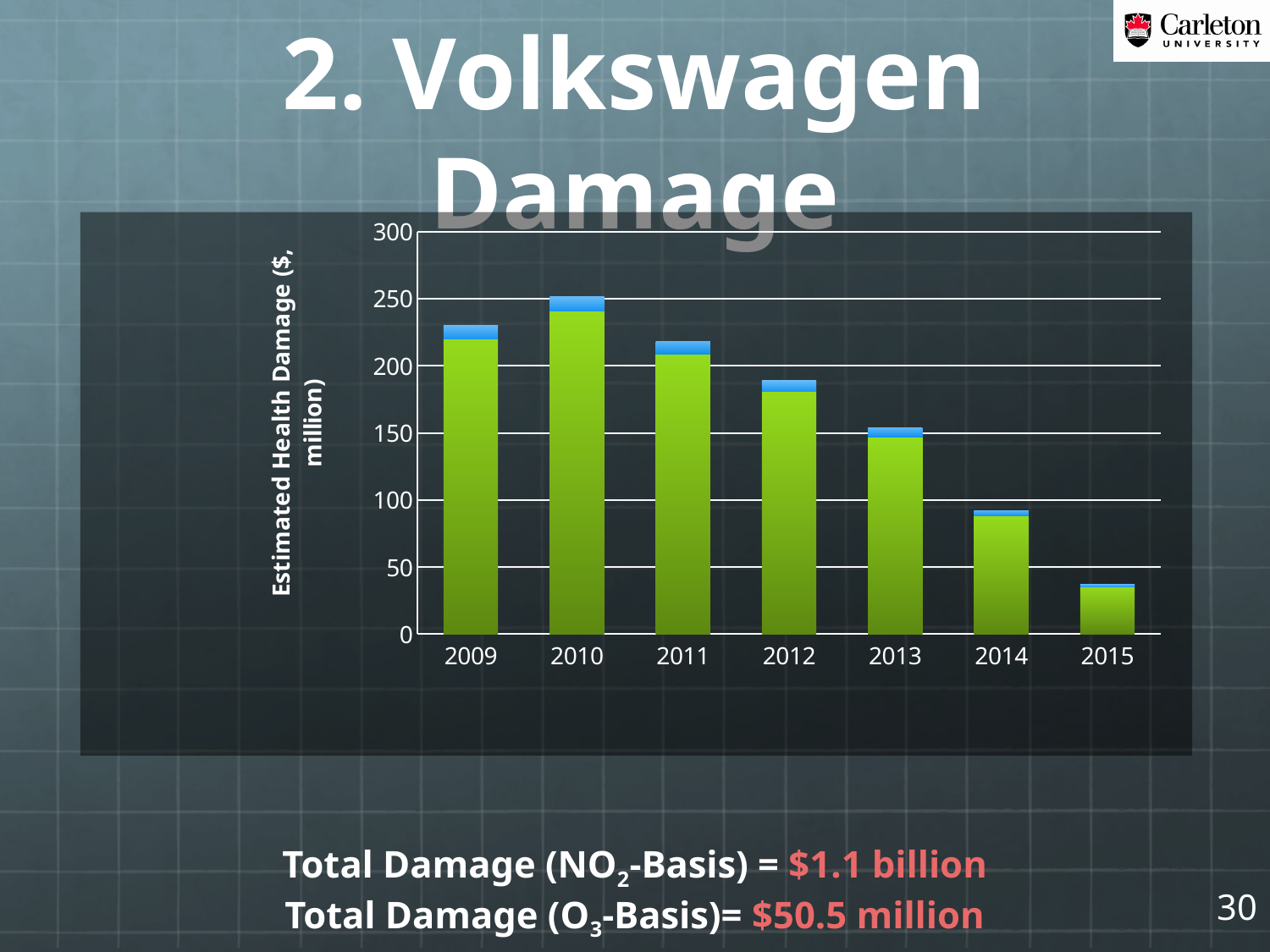
Is the value for 2014 greater or less than 100? less Which year has the lowest estimated health damage? 2015 Which is larger, the value for 2009 or the value for 2011? 2009 Which year has the highest estimated health damage? 2010 How many years are shown on the x axis of the chart? 7 Is the value for 2012 greater or less than 200? less Do the values rise or fall from 2010 to 2015? fall Is the value for 2009 greater or less than 200? greater What kind of chart is shown on the slide? bar chart Which is larger, the value for 2012 or the value for 2013? 2012 What is the label on the y axis of the chart? Estimated Health Damage ($, million)